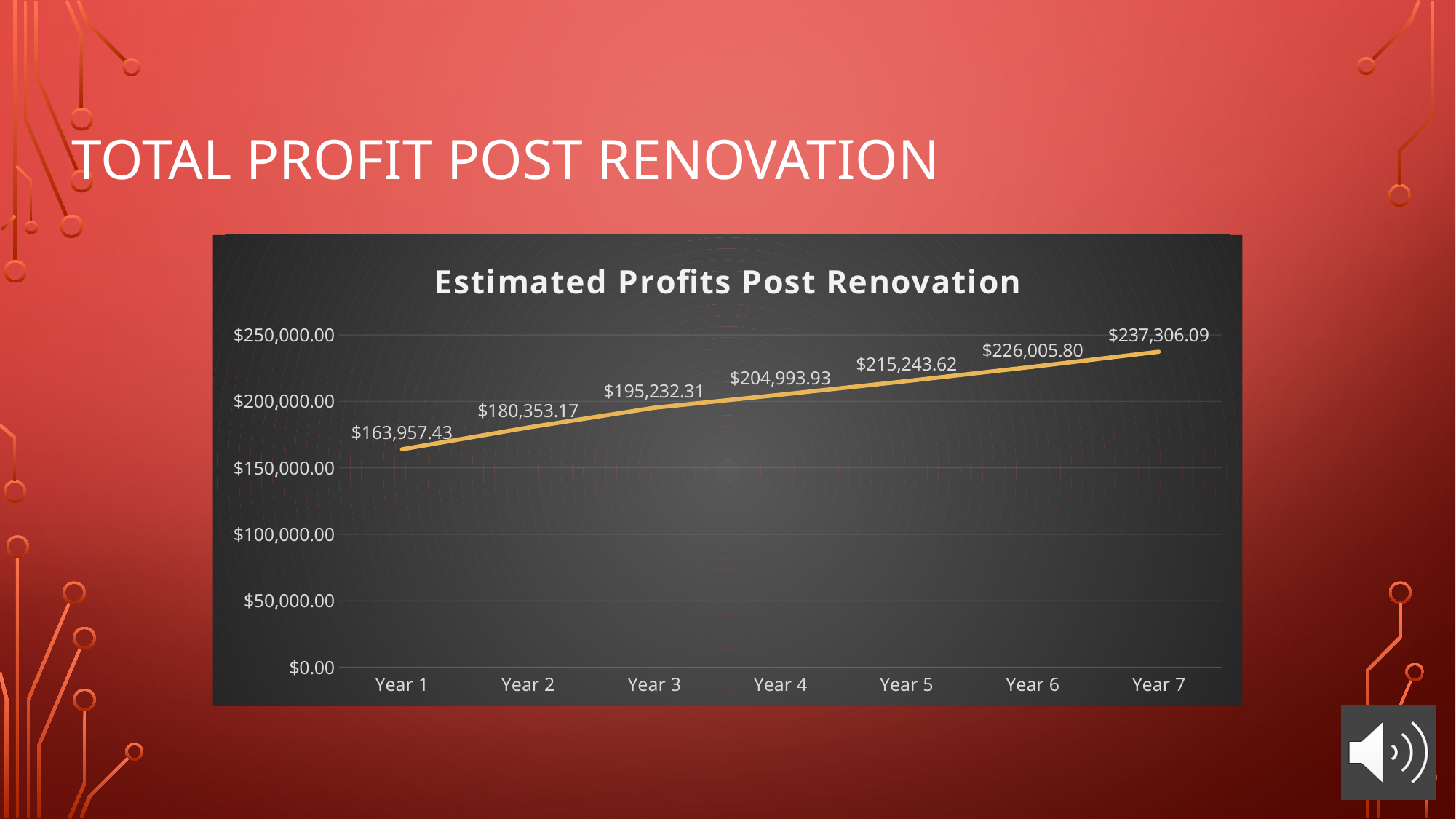
What is the difference between the estimated profit in Year 7 and Year 1? $73,348.66 What kind of chart is shown on the slide? line chart Which year has the lowest estimated profit? Year 1 What is the estimated profit for Year 1? $163,957.43 How many years are plotted on the chart? 7 Which year has the highest estimated profit? Year 7 Which is larger, the estimated profit in Year 3 or Year 5? Year 5 Do the estimated profits rise or fall from Year 1 to Year 7? rise What is the estimated profit for Year 4? $204,993.93 What is the estimated profit for Year 7? $237,306.09 What is the difference between the estimated profit in Year 2 and Year 1? $16,395.74 Is the estimated profit for Year 6 greater or less than $200,000.00? greater